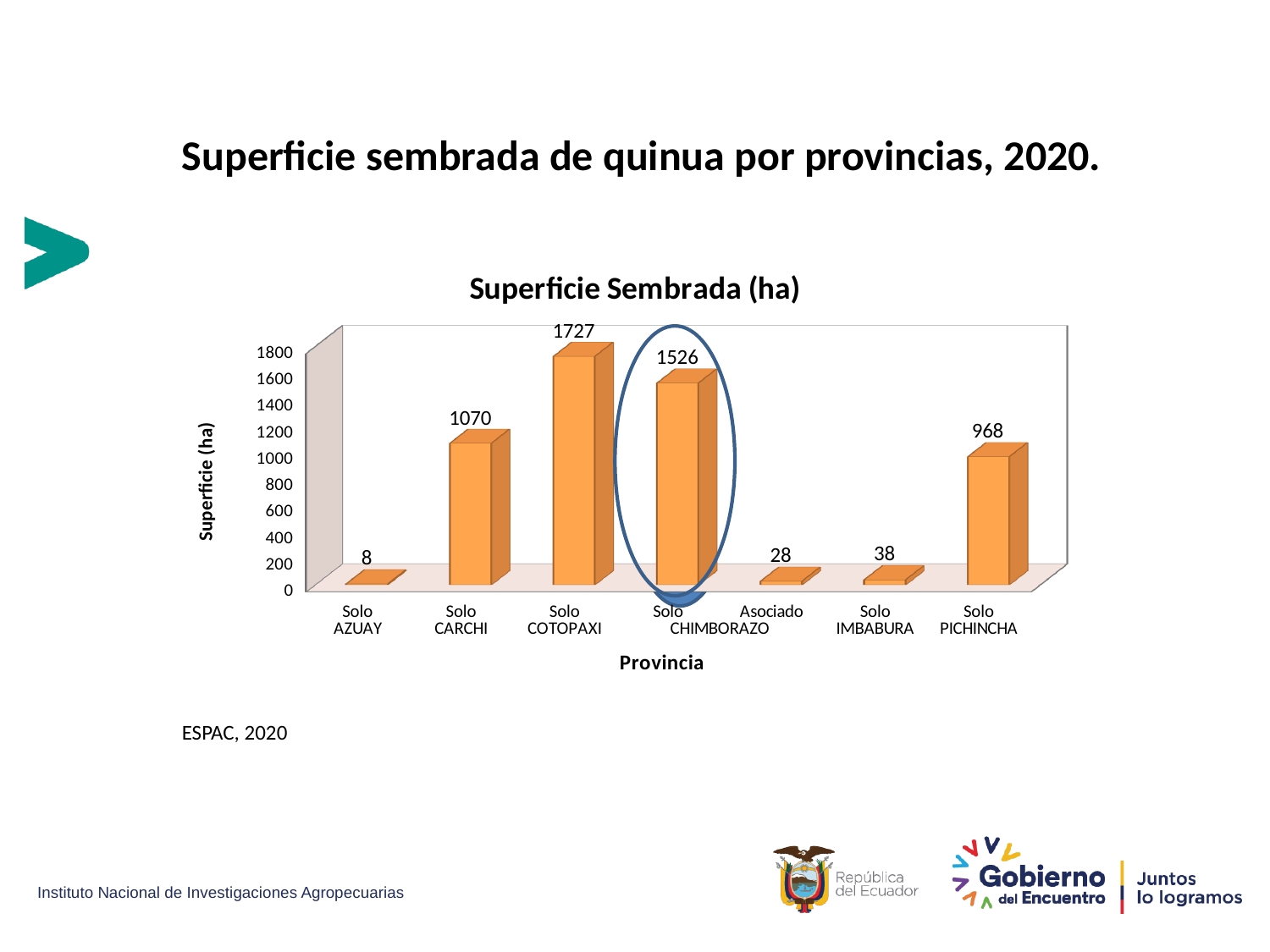
Which is larger, the value for Solo IMBABURA or the value for Asociado CHIMBORAZO? Solo IMBABURA What is the difference between the values for Solo CARCHI and Solo PICHINCHA? 102 Which province category has the highest sown area? Solo COTOPAXI What is the value for Solo PICHINCHA? 968 How many categories are shown on the x axis? 7 What is the value for Solo AZUAY? 8 What is the value for Solo COTOPAXI? 1727 What is the value for Solo CHIMBORAZO? 1526 What kind of chart is shown on the slide? Bar chart What is the difference between the values for Solo COTOPAXI and Solo CHIMBORAZO? 201 What is the title of the chart? Superficie Sembrada (ha) Which province category has the lowest sown area? Solo AZUAY